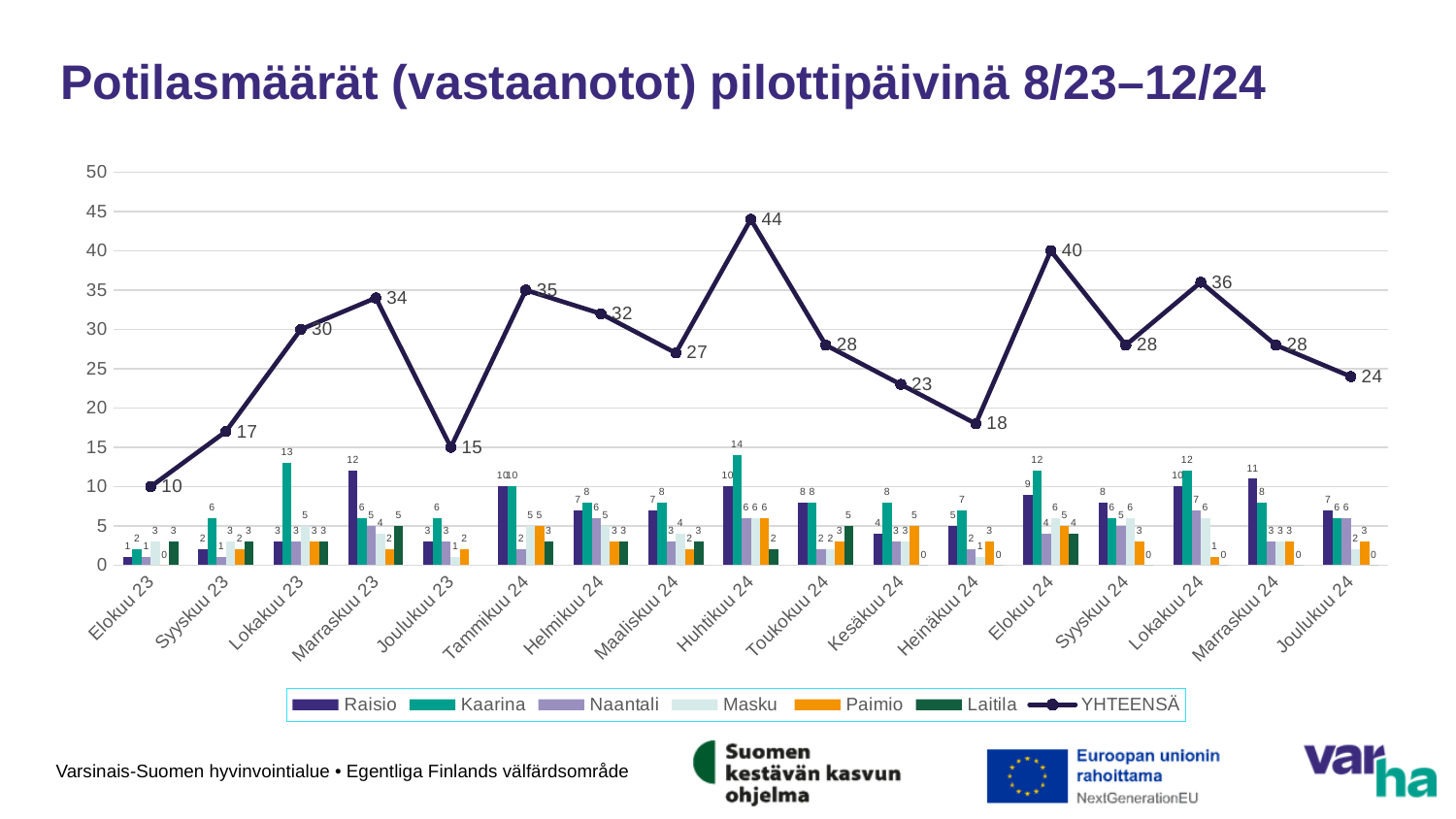
In which month does the YHTEENSÄ line reach its highest value? Huhtikuu 24 In which month is the YHTEENSÄ line at its lowest value? Elokuu 23 Is the YHTEENSÄ value for Heinäkuu 24 greater or less than 20? less What kind of chart is shown on the slide? Combination bar and line chart How many series does the legend list? 7 What is the YHTEENSÄ value for Joulukuu 23? 15 What is the difference between the YHTEENSÄ values for Huhtikuu 24 and Toukokuu 24? 16 Which series is drawn as a line rather than bars? YHTEENSÄ How many months are shown on the x axis? 17 Does the YHTEENSÄ line rise or fall from Elokuu 23 to Marraskuu 23? rise What is the YHTEENSÄ value for Huhtikuu 24? 44 Which month has the larger YHTEENSÄ value, Elokuu 24 or Lokakuu 24? Elokuu 24